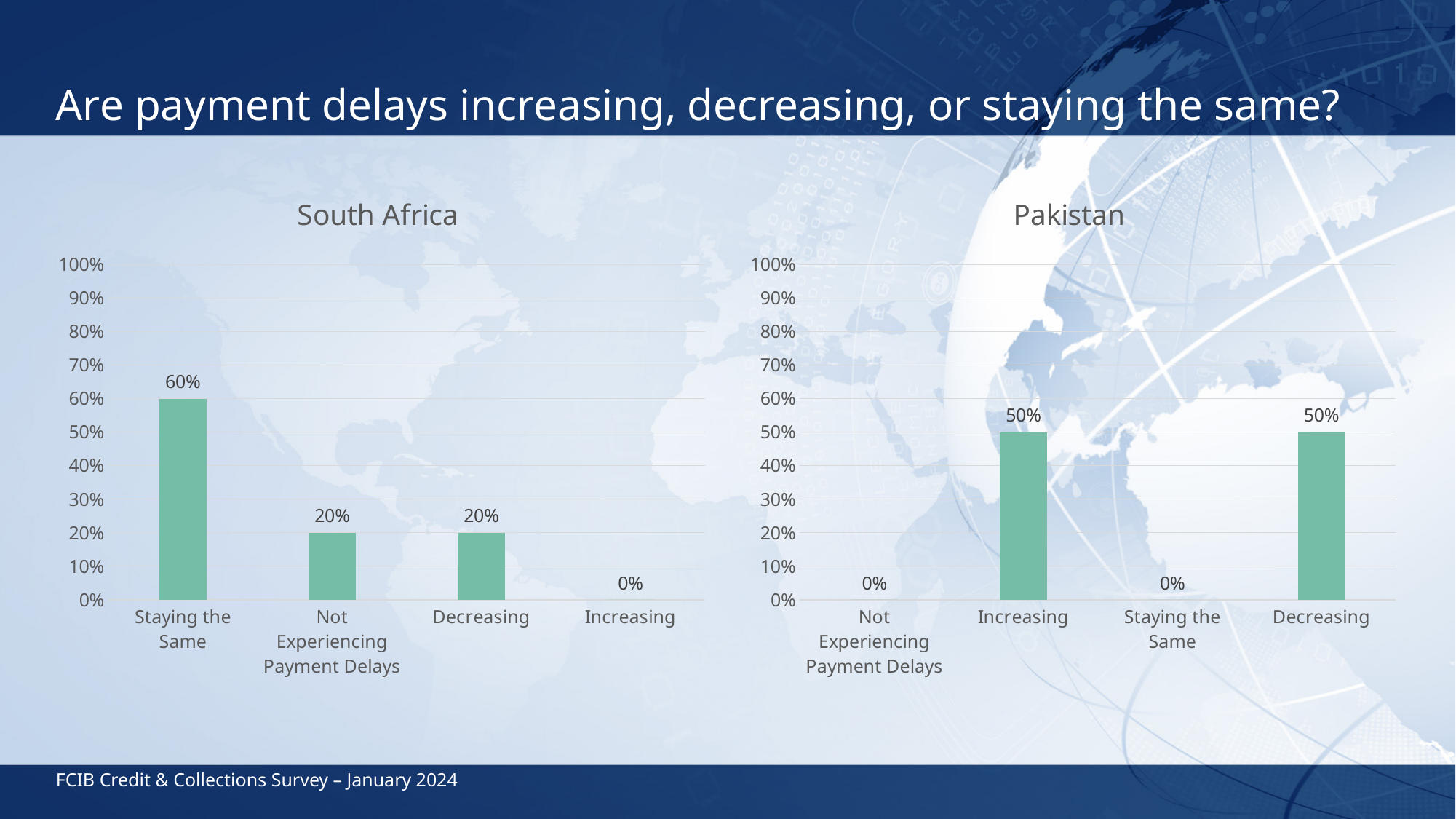
How many categories are shown in the Pakistan chart? 4 In the Pakistan chart, which is larger, Increasing or Not Experiencing Payment Delays? Increasing In the South Africa chart, which category has the lowest value? Increasing Which is larger, Staying the Same in the South Africa chart or Decreasing in the Pakistan chart? Staying the Same in the South Africa chart In the Pakistan chart, what is the value for Increasing? 50% In the South Africa chart, what is the value for Staying the Same? 60% What kind of chart is the South Africa chart? Bar chart In the South Africa chart, what is the difference between Staying the Same and Decreasing? 40% In the South Africa chart, what is the value for Not Experiencing Payment Delays? 20% In the South Africa chart, what is the value for Increasing? 0% In the Pakistan chart, what is the value for Staying the Same? 0% In the South Africa chart, which category has the highest value? Staying the Same